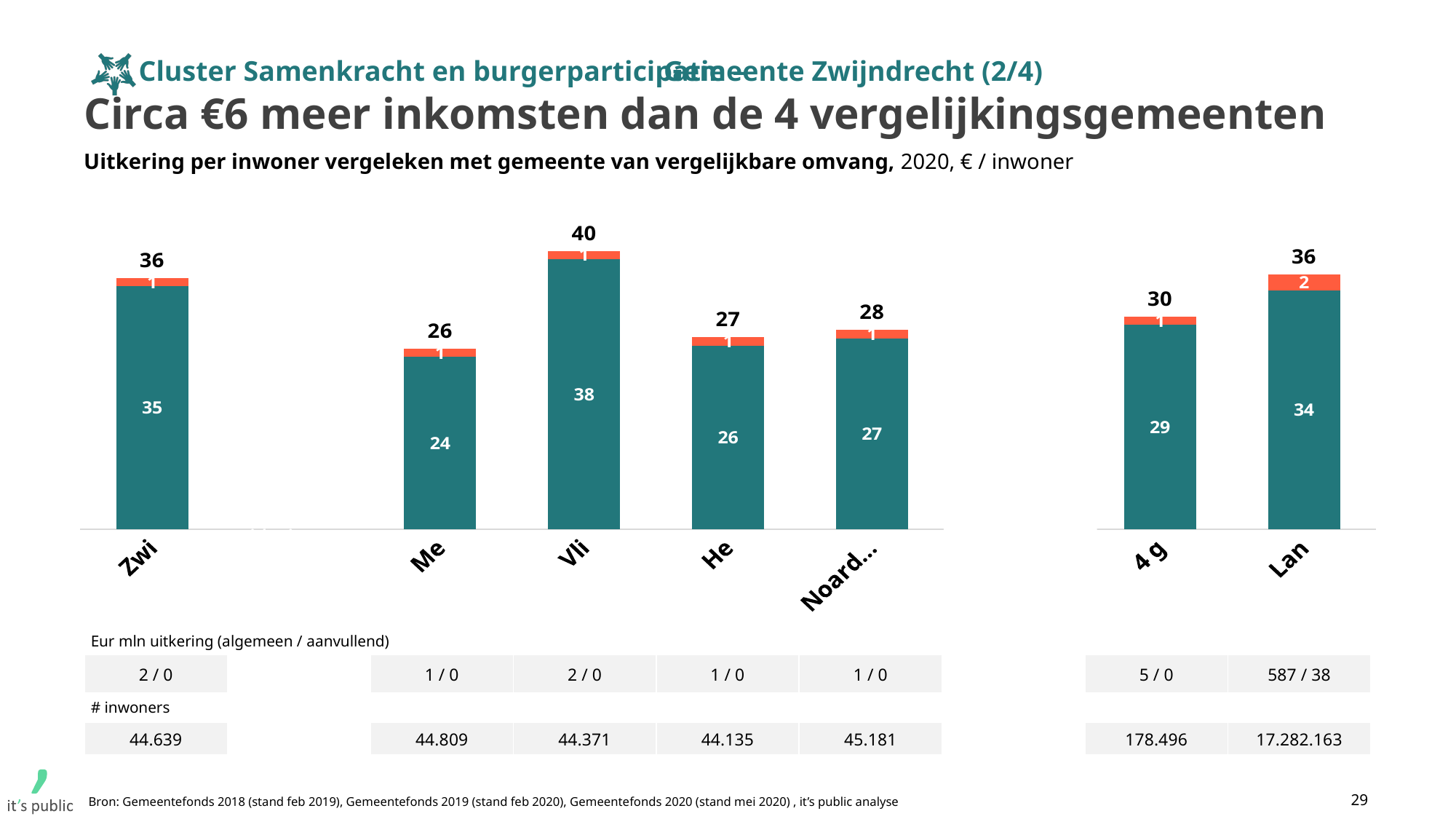
What is the total value shown above the bar for Vli? 40 What is the total of the stacked bar for 4 g? 30 What is the value of the orange (upper) segment of the bar for Lan? 2 Which category has the lowest total value? Me What kind of chart is shown on the slide? Stacked bar chart What unit is stated in the chart subtitle for the values? € / inwoner What is the value of the teal (lower) segment of the bar for Zwi? 35 How many bars are shown in the chart? 7 What is the value of the teal (lower) segment of the bar for 4 g? 29 Which has a larger total, He or Noard...? Noard... What is the difference between the total for Zwi and the total for Me? 10 Which category has the highest total value? Vli